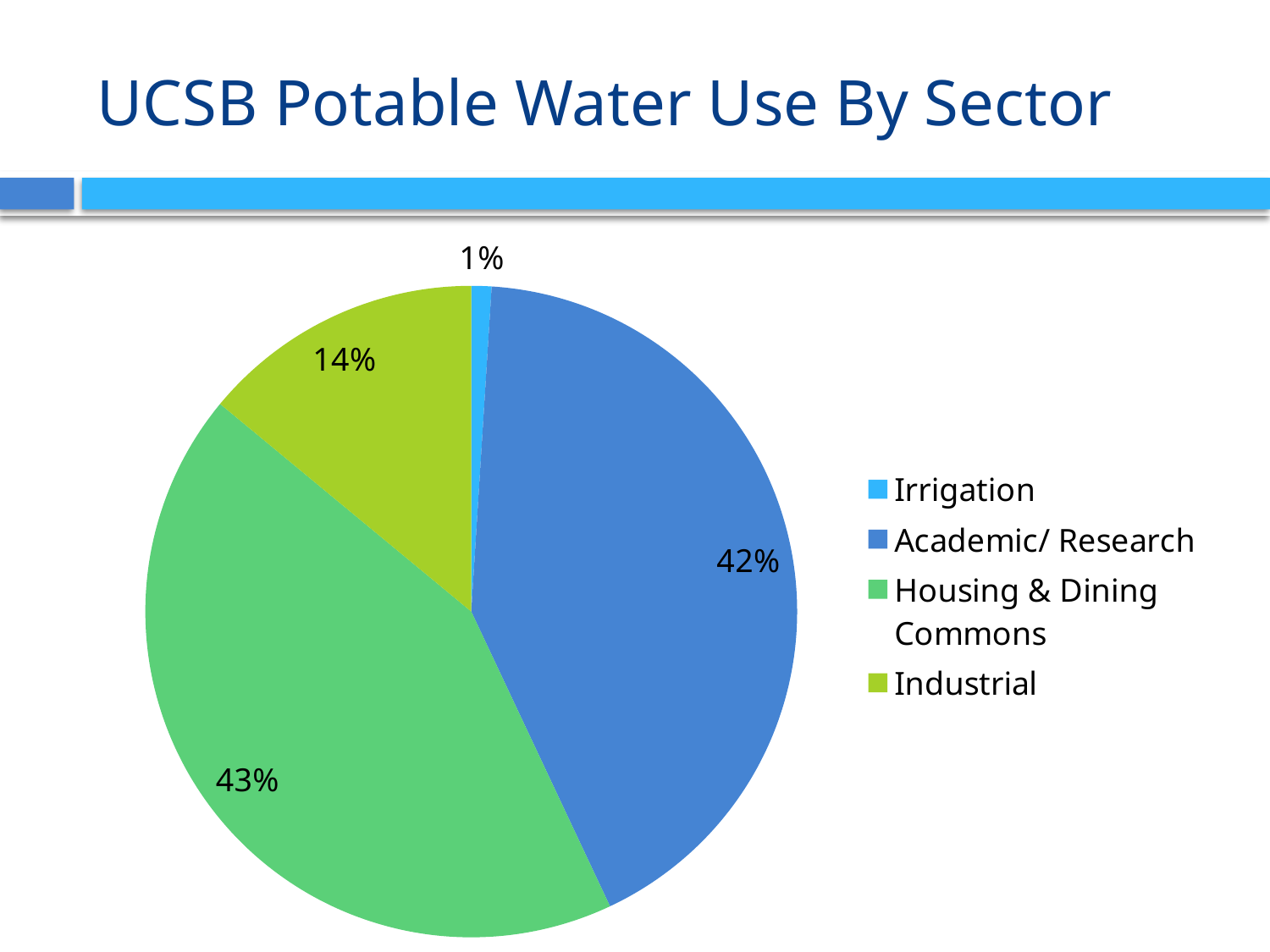
What share of potable water use is attributed to Irrigation? 1% What is the difference in percentage points between the Housing & Dining Commons share and the Industrial share? 29 Which sector has the largest share of potable water use? Housing & Dining Commons What share of potable water use is attributed to Housing & Dining Commons? 43% What is the title of the chart? UCSB Potable Water Use By Sector Which sector has a larger share, Academic/ Research or Industrial? Academic/ Research What type of chart is shown on the slide? pie chart Which sector has the smallest share of potable water use? Irrigation How many sectors are shown in the pie chart? 4 What colour represents Industrial in the pie chart? yellow-green What share of potable water use is attributed to Industrial? 14% What share of potable water use is attributed to Academic/ Research? 42%